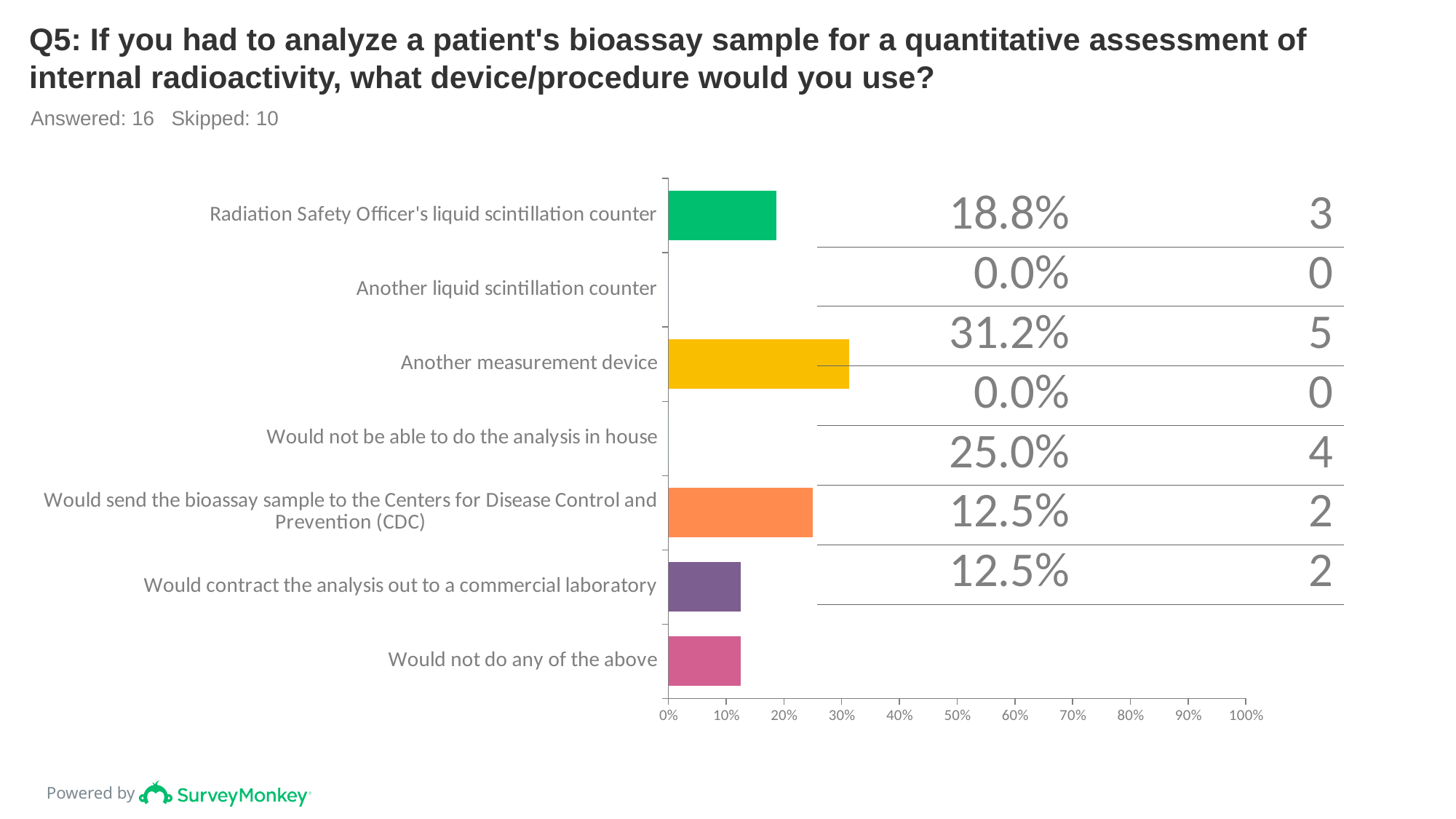
How many respondents chose "Would send the bioassay sample to the Centers for Disease Control and Prevention (CDC)"? 4 Is the value for "Another measurement device" greater or less than 30%? greater Which is larger: the percentage for "Radiation Safety Officer's liquid scintillation counter" or for "Would contract the analysis out to a commercial laboratory"? Radiation Safety Officer's liquid scintillation counter Which answer category has the highest percentage? Another measurement device What is the difference in percentage between "Another measurement device" and "Would send the bioassay sample to the Centers for Disease Control and Prevention (CDC)"? 6.2% How many answer categories are listed on the chart? 7 What percentage of respondents chose "Radiation Safety Officer's liquid scintillation counter"? 18.8% How many respondents answered this question according to the slide? 16 What percentage of respondents chose "Another measurement device"? 31.2% What kind of chart is shown on the slide? bar chart How many respondents chose "Another liquid scintillation counter"? 0 What colour is the bar for "Another measurement device"? yellow